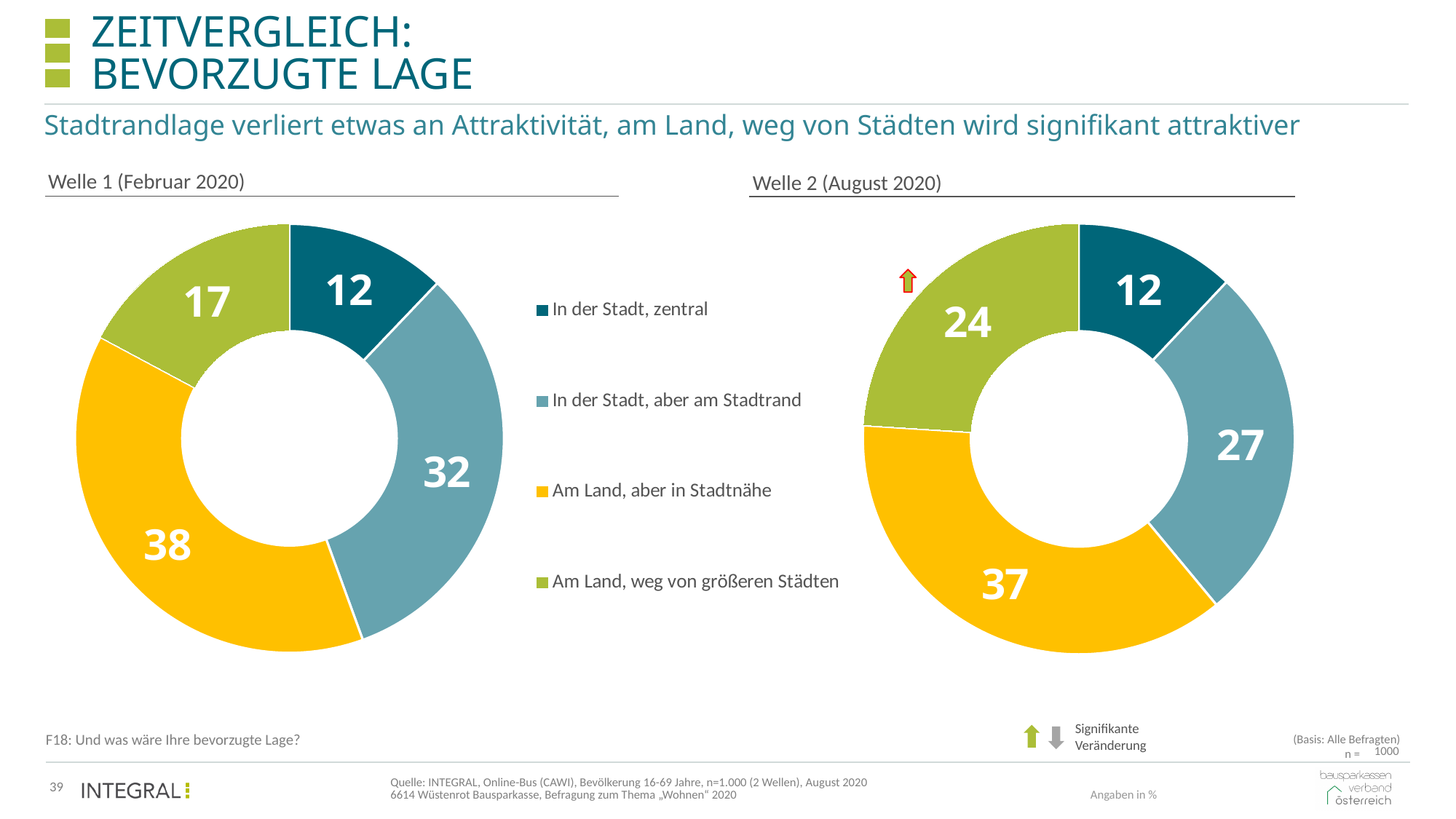
What is the difference between the "Am Land, weg von größeren Städten" values in the Welle 2 (August 2020) chart and the Welle 1 (Februar 2020) chart? 7 In the Welle 2 (August 2020) chart, what is the value for "Am Land, weg von größeren Städten"? 24 In the Welle 1 (Februar 2020) chart, what is the value for "Am Land, aber in Stadtnähe"? 38 Is the value for "In der Stadt, aber am Stadtrand" larger in the Welle 1 (Februar 2020) chart or the Welle 2 (August 2020) chart? Welle 1 (Februar 2020) In the Welle 1 (Februar 2020) chart, which category has the highest value? Am Land, aber in Stadtnähe In the Welle 2 (August 2020) chart, which category has the lowest value? In der Stadt, zentral How many categories does the Welle 1 (Februar 2020) chart show? 4 Which is larger in the Welle 2 (August 2020) chart: "In der Stadt, aber am Stadtrand" or "Am Land, weg von größeren Städten"? In der Stadt, aber am Stadtrand Which colour represents "Am Land, aber in Stadtnähe" in the legend? Yellow What kind of chart is the Welle 2 (August 2020) chart? Doughnut chart In the Welle 2 (August 2020) chart, what is the value for "In der Stadt, aber am Stadtrand"? 27 In the Welle 1 (Februar 2020) chart, what is the difference between "In der Stadt, aber am Stadtrand" and "In der Stadt, zentral"? 20